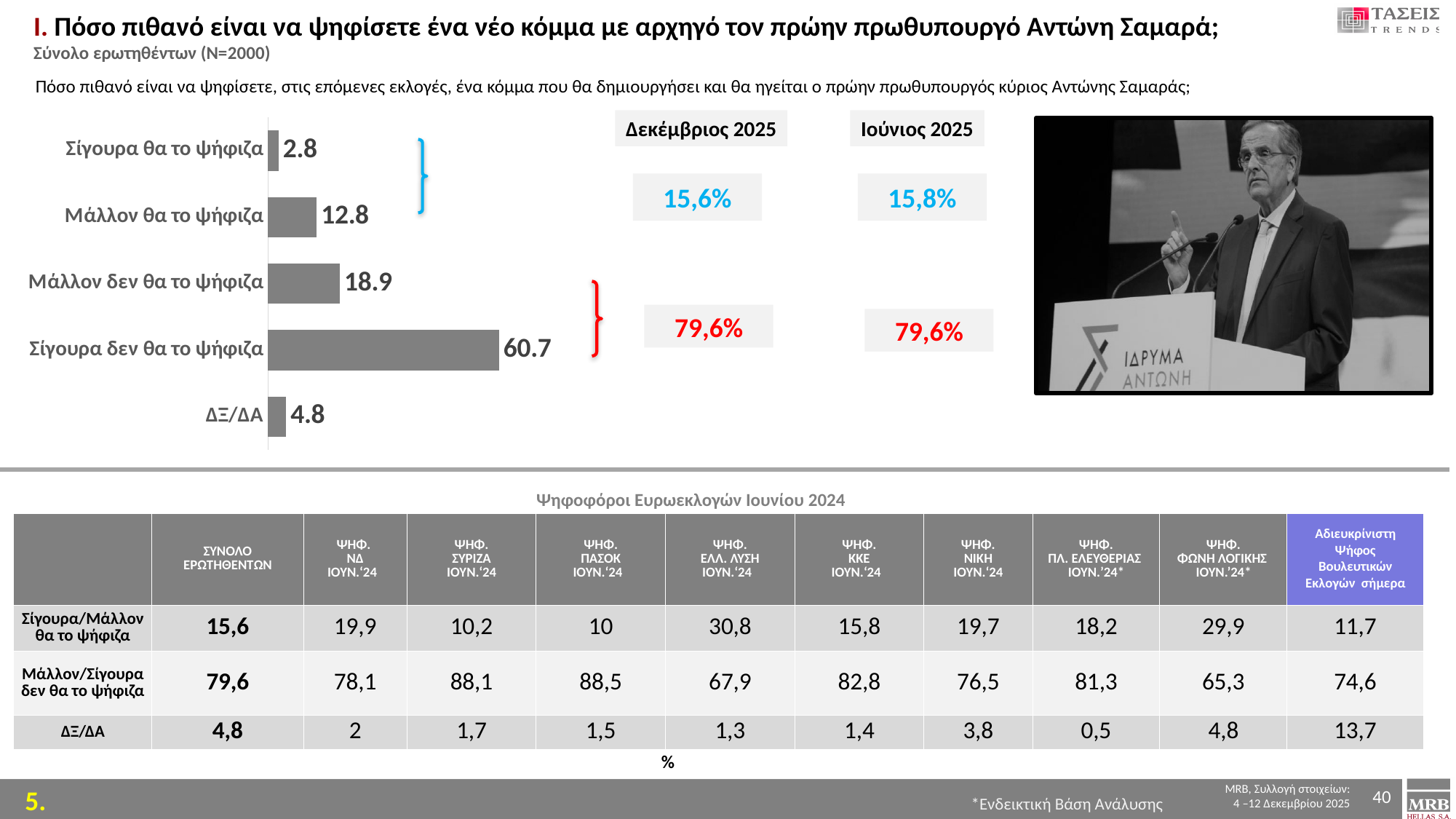
In the bar chart, which is larger: the value for "Μάλλον δεν θα το ψήφιζα" or the value for "Μάλλον θα το ψήφιζα"? Μάλλον δεν θα το ψήφιζα What value does the bar chart show for "Σίγουρα δεν θα το ψήφιζα"? 60.7 What is the difference between the values for "Μάλλον θα το ψήφιζα" and "Σίγουρα θα το ψήφιζα" in the bar chart? 10.0 Which category has the highest value in the bar chart? Σίγουρα δεν θα το ψήφιζα What is the combined total of the "Σίγουρα θα το ψήφιζα" and "Μάλλον θα το ψήφιζα" bars in the bar chart? 15.6 What is the difference between the values for "Σίγουρα δεν θα το ψήφιζα" and "Μάλλον δεν θα το ψήφιζα" in the bar chart? 41.8 What value does the bar chart show for "Σίγουρα θα το ψήφιζα"? 2.8 What value does the bar chart show for "ΔΞ/ΔΑ"? 4.8 How many categories are shown in the bar chart? 5 What value does the bar chart show for "Μάλλον θα το ψήφιζα"? 12.8 Which category has the lowest value in the bar chart? Σίγουρα θα το ψήφιζα What type of chart is used to show the responses on the slide? Bar chart